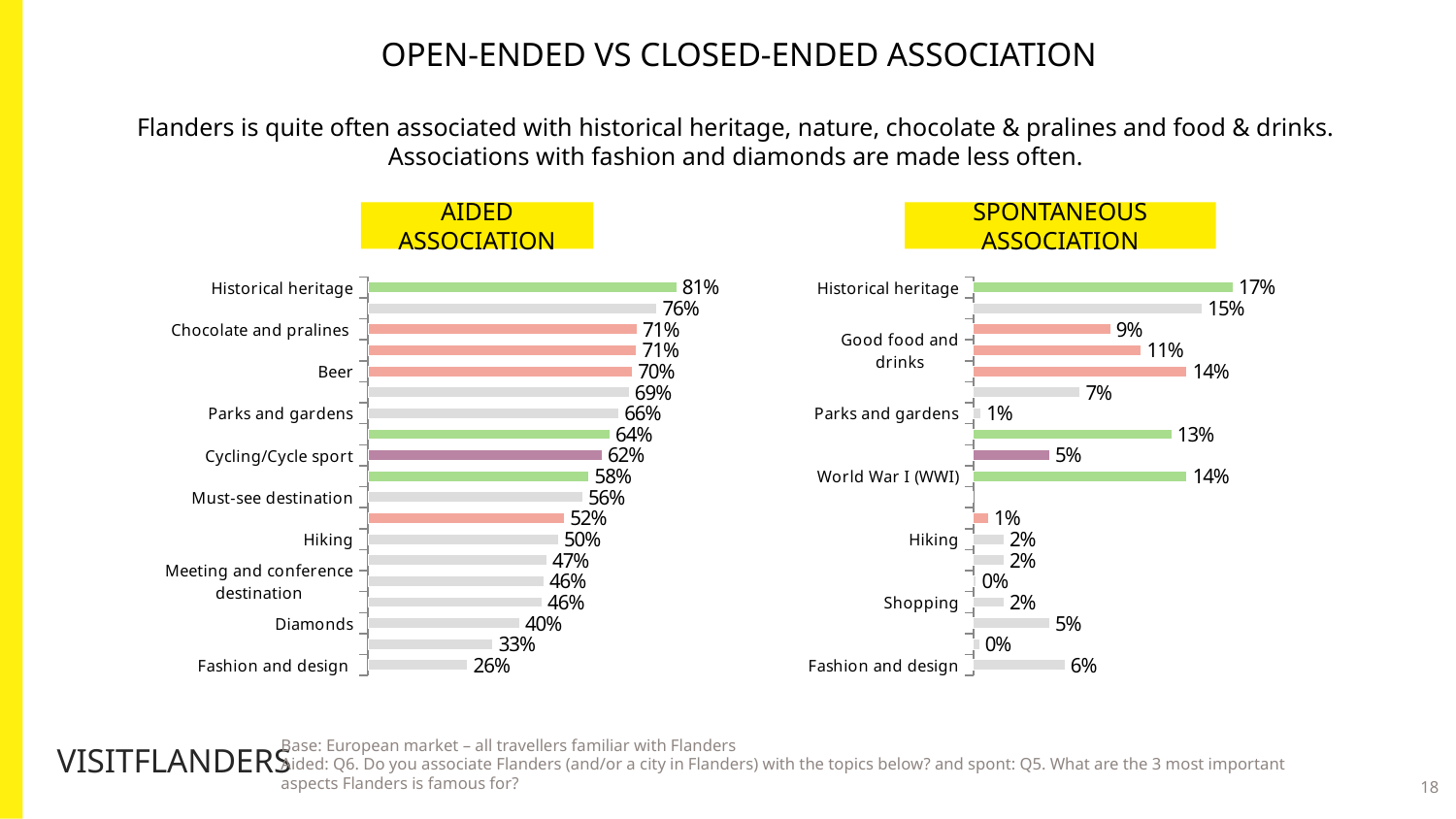
In the AIDED ASSOCIATION chart, what is the value for Cycling/Cycle sport? 62% In the AIDED ASSOCIATION chart, what is the difference between Beer and Hiking? 20% In the AIDED ASSOCIATION chart, which labelled category has the highest value? Historical heritage In the SPONTANEOUS ASSOCIATION chart, what is the difference between Historical heritage and World War I (WWI)? 3% In the AIDED ASSOCIATION chart, what is the value for Fashion and design? 26% In the SPONTANEOUS ASSOCIATION chart, what is the value for Historical heritage? 17% What type of chart is the AIDED ASSOCIATION chart? Bar chart In the AIDED ASSOCIATION chart, what is the value for Historical heritage? 81% In the AIDED ASSOCIATION chart, which is larger, Chocolate and pralines or Must-see destination? Chocolate and pralines In the AIDED ASSOCIATION chart, what is the value for Diamonds? 40% In the SPONTANEOUS ASSOCIATION chart, what is the value for Fashion and design? 6% In the AIDED ASSOCIATION chart, which labelled category has the lowest value? Fashion and design